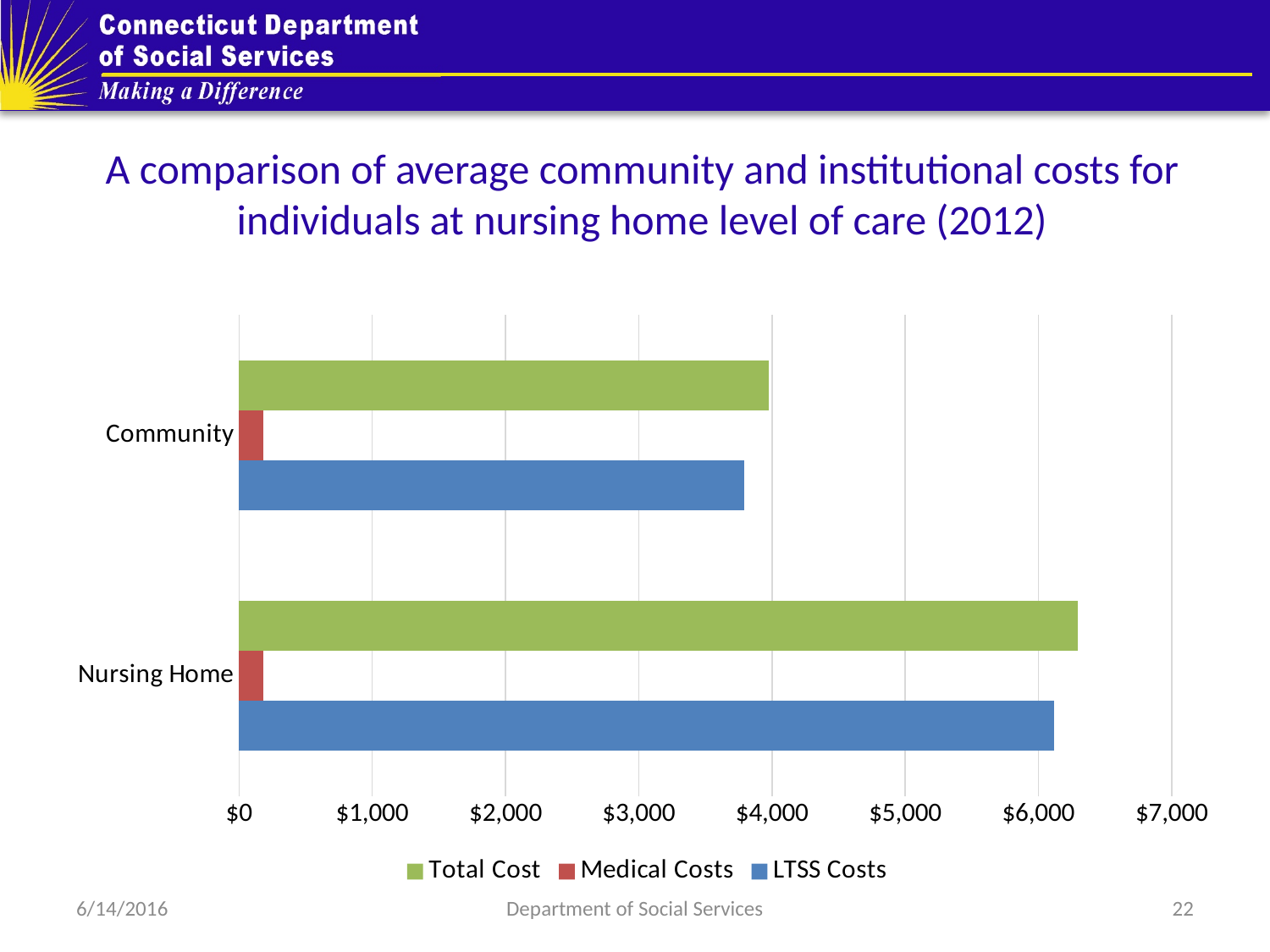
What kind of chart is shown on the slide? bar chart How many series does the legend list? 3 Is the Medical Costs value for Nursing Home greater or less than $1,000? less Which category has the higher Total Cost, Community or Nursing Home? Nursing Home Is the Total Cost for Community greater or less than $3,000? greater How many categories are shown on the vertical axis? 2 Which series is shown in green in the legend? Total Cost Is the Total Cost for Nursing Home greater or less than $6,000? greater Which series has the highest value for Community? Total Cost Which series has the lowest value for Nursing Home? Medical Costs